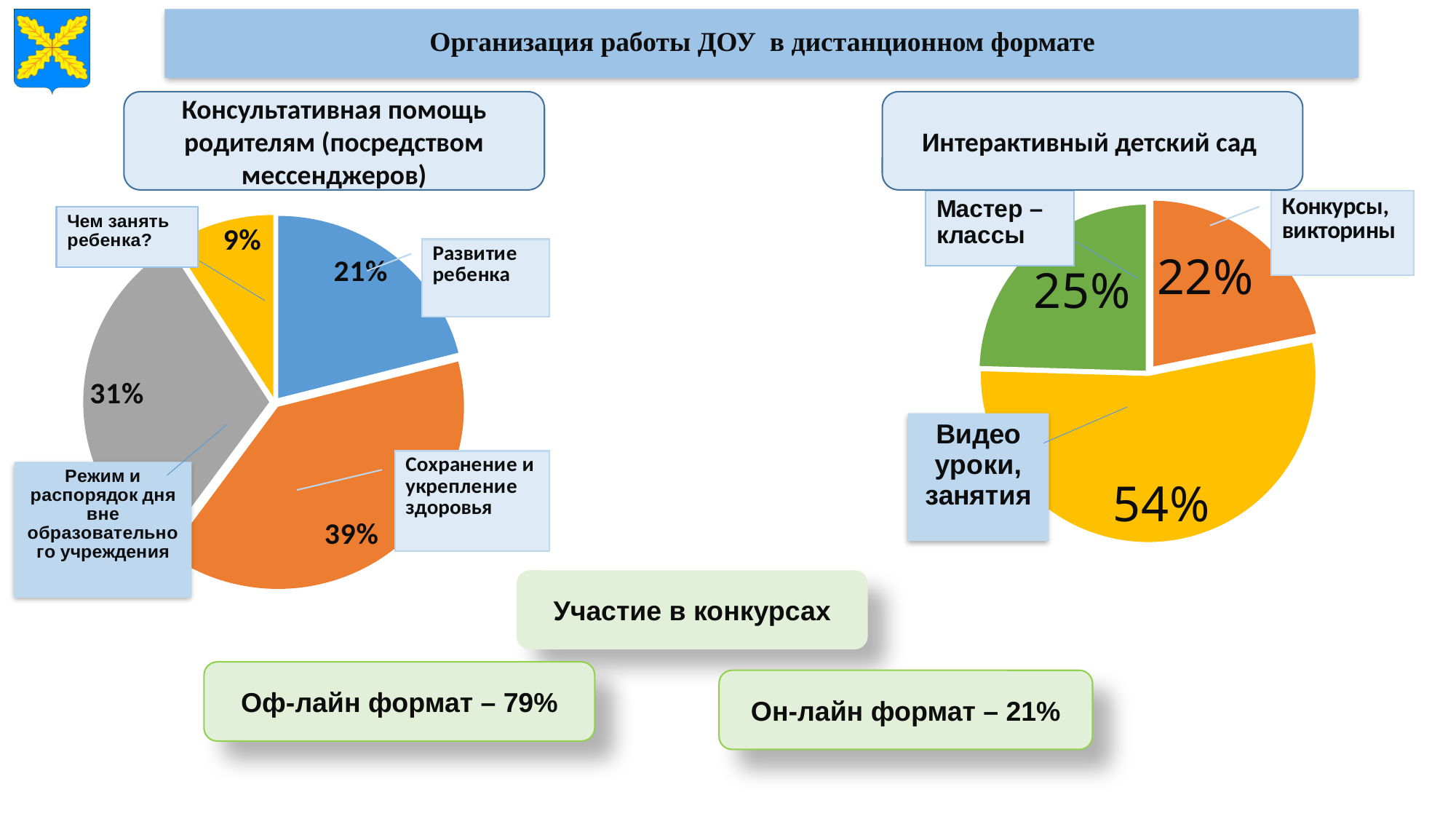
How many slices does the right pie chart (Интерактивный детский сад) have? 3 In the right pie chart (Интерактивный детский сад), what share is labelled for Мастер-классы? 25% In the left pie chart (Консультативная помощь родителям), which category has the largest slice? Сохранение и укрепление здоровья What type of chart is used for Интерактивный детский сад? Pie chart In the right pie chart (Интерактивный детский сад), which is larger: Мастер-классы or Конкурсы, викторины? Мастер-классы In the right pie chart (Интерактивный детский сад), what share is labelled for Видео уроки, занятия? 54% How many slices does the left pie chart (Консультативная помощь родителям) have? 4 In the left pie chart (Консультативная помощь родителям), what share is labelled for Сохранение и укрепление здоровья? 39% In the right pie chart (Интерактивный детский сад), which category has the largest slice? Видео уроки, занятия In the left pie chart (Консультативная помощь родителям), what is the difference between the shares for Сохранение и укрепление здоровья and Режим и распорядок дня вне образовательного учреждения? 8% In the left pie chart (Консультативная помощь родителям), which category has the smallest slice? Чем занять ребенка? In the left pie chart (Консультативная помощь родителям), what share is labelled for Развитие ребенка? 21%